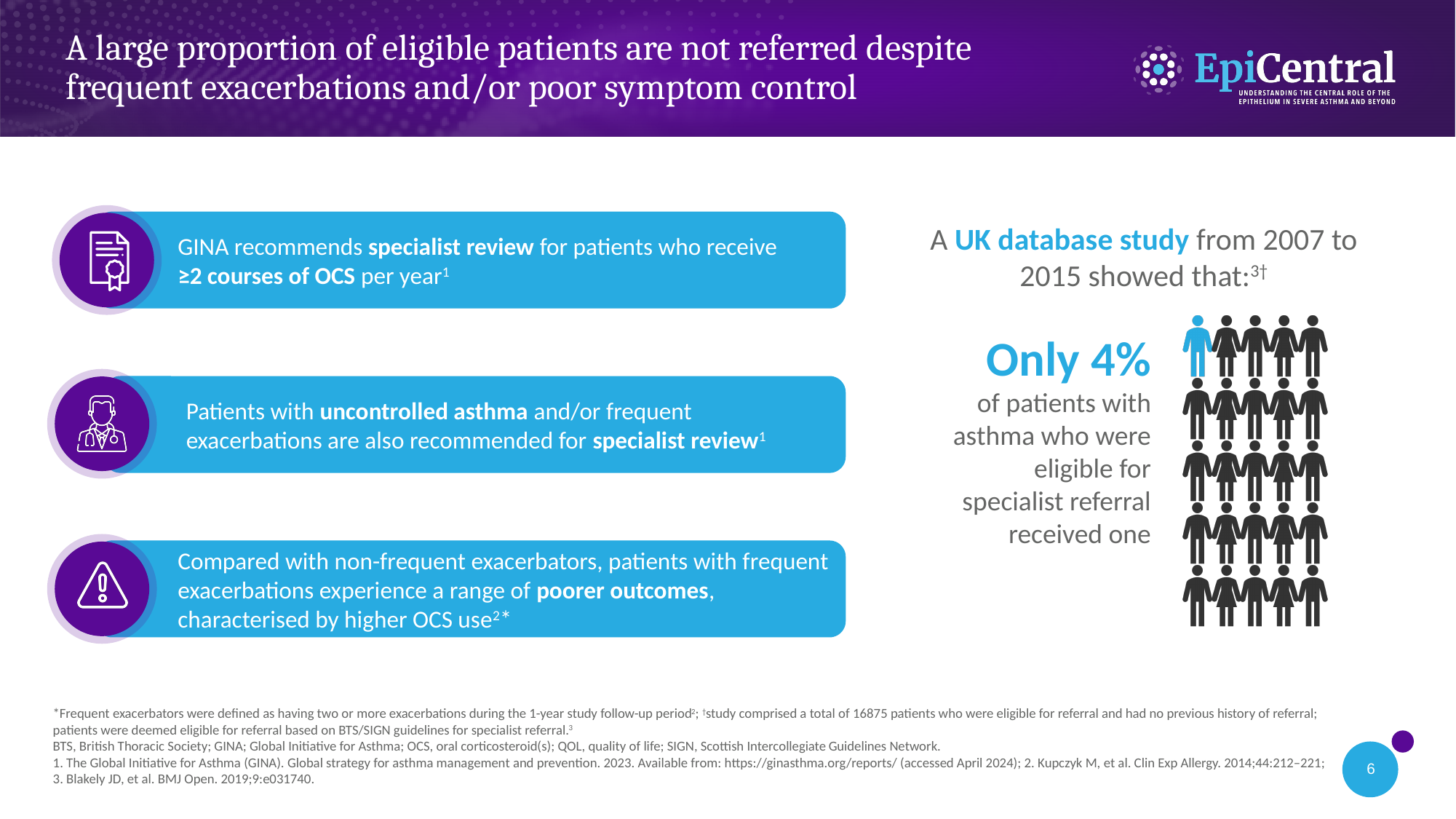
Over which years was the UK database study shown in the pictogram conducted? 2007 to 2015 How many person icons are shown in the pictogram on the right of the slide? 25 How many of the person icons in the pictogram are highlighted in blue? 1 Is the share of eligible patients who received a specialist referral, as shown in the pictogram, greater or less than 50%? less What colour is used for the icon representing patients who received a specialist referral in the pictogram? Blue What kind of chart is used on the right of the slide to show the share of eligible patients who received a referral? Pictogram (icon array) According to the pictogram on the right, what percentage of patients with asthma who were eligible for specialist referral received one? 4%